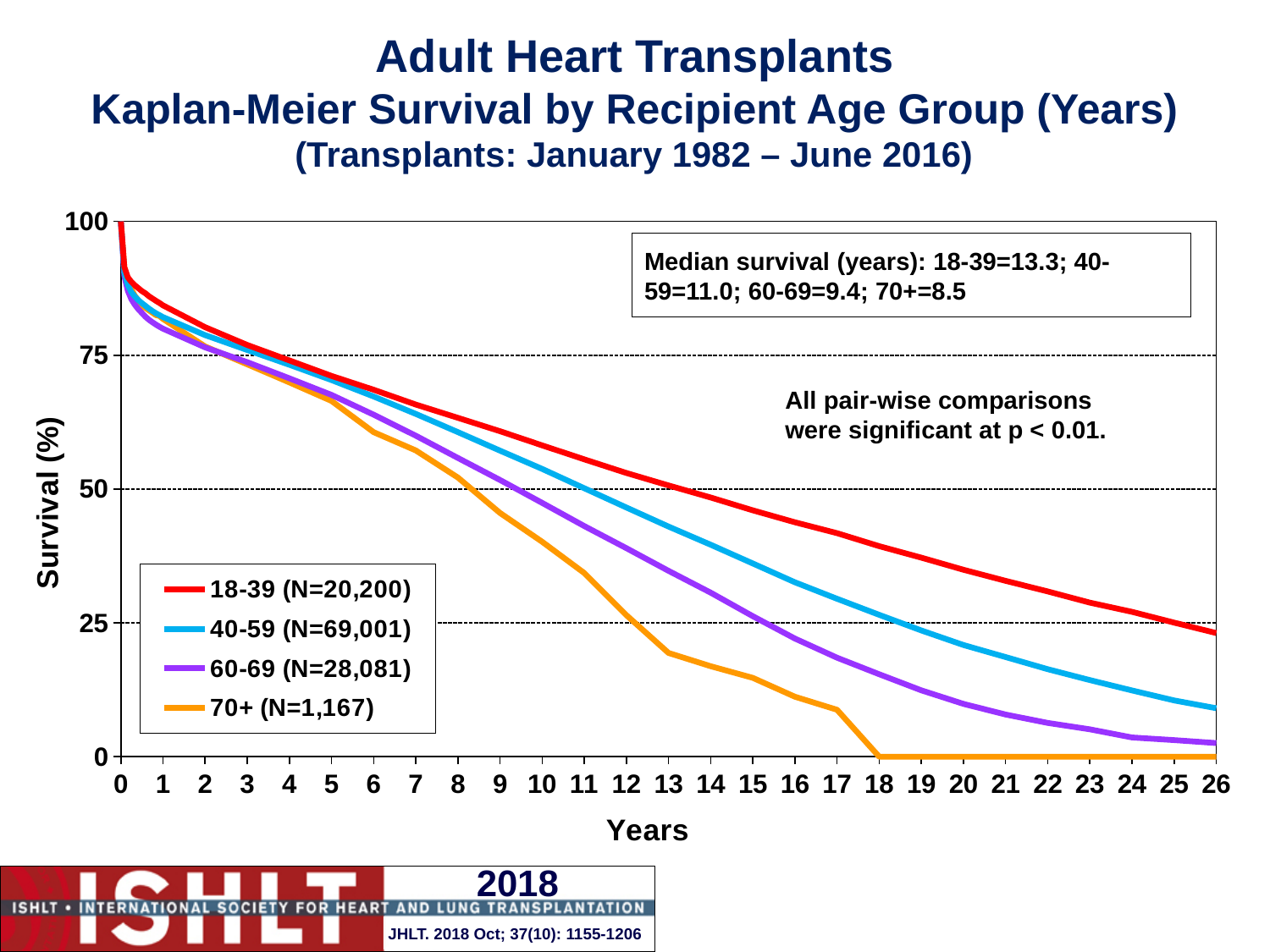
What kind of chart is shown on the slide? line chart Which age group has the lowest median survival? 70+ How many recipient age groups does the legend list? 4 Which age group has the highest median survival? 18-39 At 15 years, which group has higher survival, 18-39 or 70+? 18-39 At how many years does the 70+ survival curve reach 0%? 18 Is the survival for the 40-59 group at 26 years greater or less than 25%? less Do the survival curves rise or fall as years increase? fall What is the N for the 40-59 age group shown in the legend? 69,001 What is the median survival in years for the 70+ age group? 8.5 What is the median survival in years for the 18-39 age group? 13.3 What is the difference in median survival (years) between the 18-39 and 70+ groups? 4.8